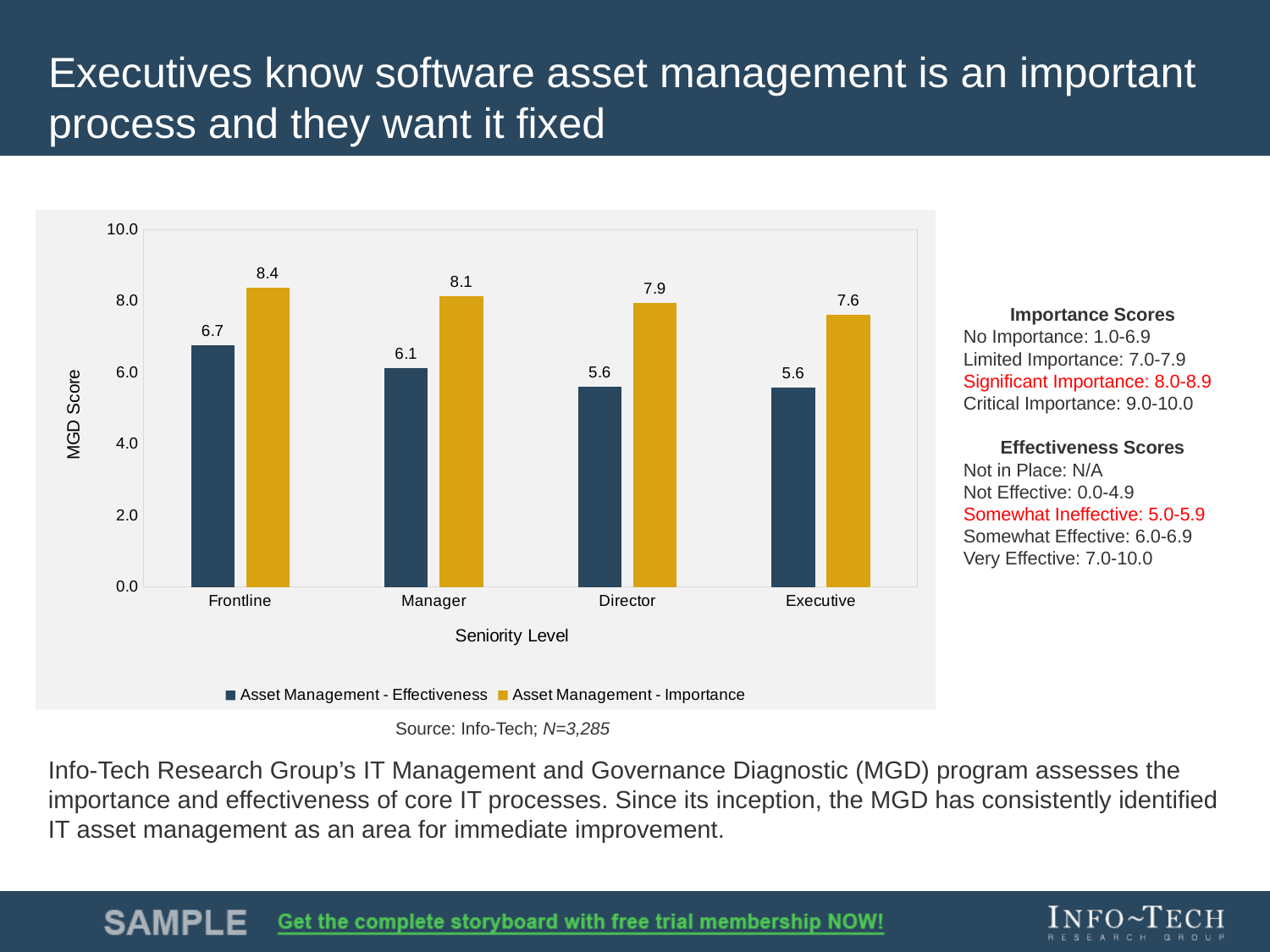
What is the Asset Management - Effectiveness score for Manager? 6.1 What is the Asset Management - Importance score for Frontline? 8.4 What kind of chart is shown on the slide? Bar chart What is the Asset Management - Importance score for Executive? 7.6 How many series does the legend list? 2 How many seniority levels are shown on the x axis? 4 Which is larger, the Effectiveness score for Frontline or the Effectiveness score for Manager? Frontline What is the label of the y axis? MGD Score Do the Asset Management - Importance scores rise or fall from Frontline to Executive? Fall Which seniority level has the highest Asset Management - Importance score? Frontline Which seniority level has the lowest Asset Management - Importance score? Executive What is the difference between the Importance and Effectiveness scores for Director? 2.3